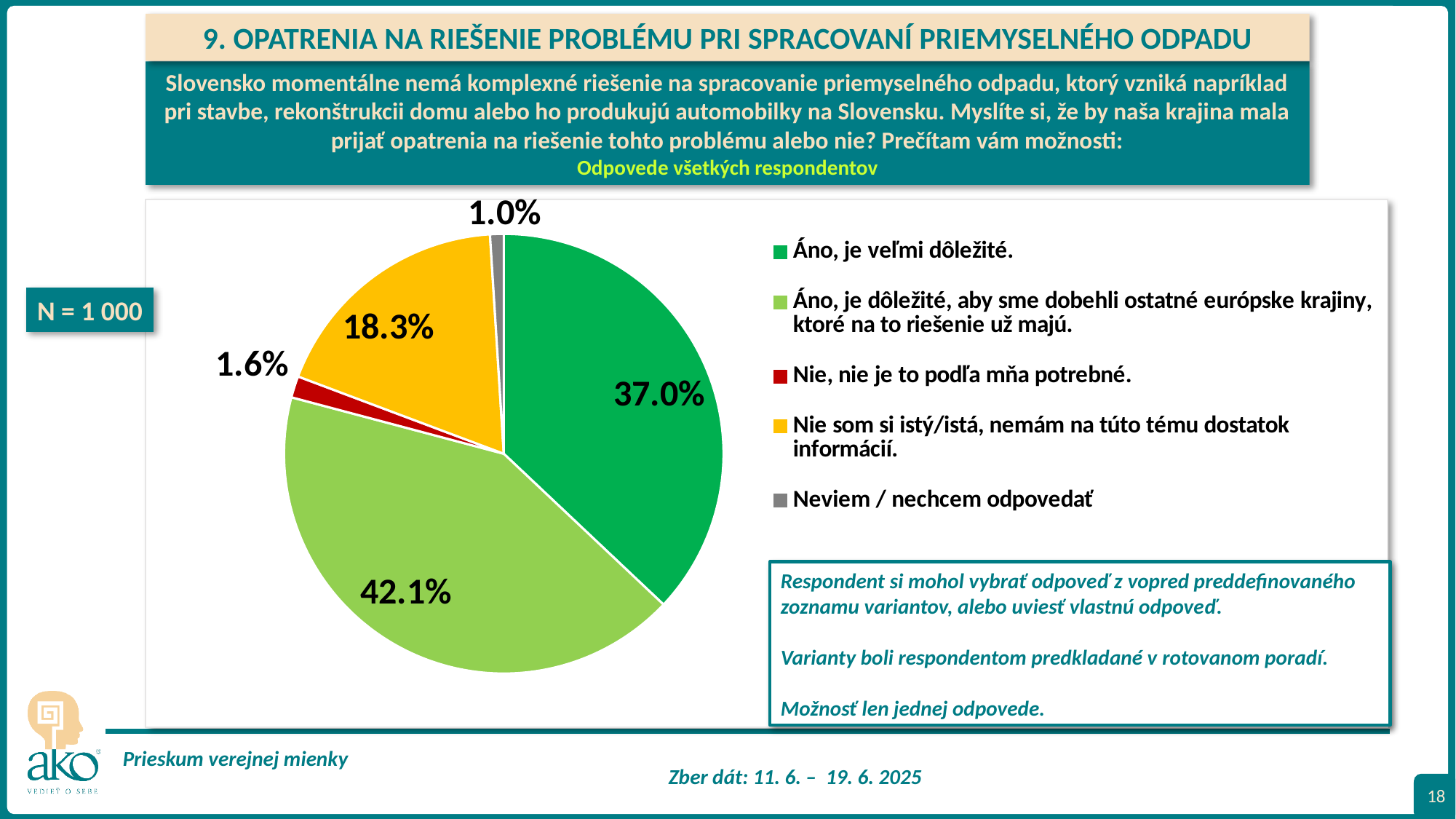
What share of respondents answered "Áno, je dôležité, aby sme dobehli ostatné európske krajiny, ktoré na to riešenie už majú."? 42.1% What share of respondents answered "Áno, je veľmi dôležité."? 37.0% What share of respondents answered "Nie, nie je to podľa mňa potrebné."? 1.6% Which answer option has the largest share of the pie? Áno, je dôležité, aby sme dobehli ostatné európske krajiny, ktoré na to riešenie už majú. What share of respondents answered "Neviem / nechcem odpovedať"? 1.0% Which answer option has the smallest share of the pie? Neviem / nechcem odpovedať Which is larger: the share for "Nie, nie je to podľa mňa potrebné." or the share for "Neviem / nechcem odpovedať"? Nie, nie je to podľa mňa potrebné. What colour is the slice for "Nie som si istý/istá, nemám na túto tému dostatok informácií."? yellow What kind of chart is shown on the slide? pie chart What is the difference in percentage points between the "Áno, je dôležité, aby sme dobehli ostatné európske krajiny..." slice and the "Áno, je veľmi dôležité." slice? 5.1 percentage points How many answer options does the legend list? 5 What share of respondents answered "Nie som si istý/istá, nemám na túto tému dostatok informácií."? 18.3%